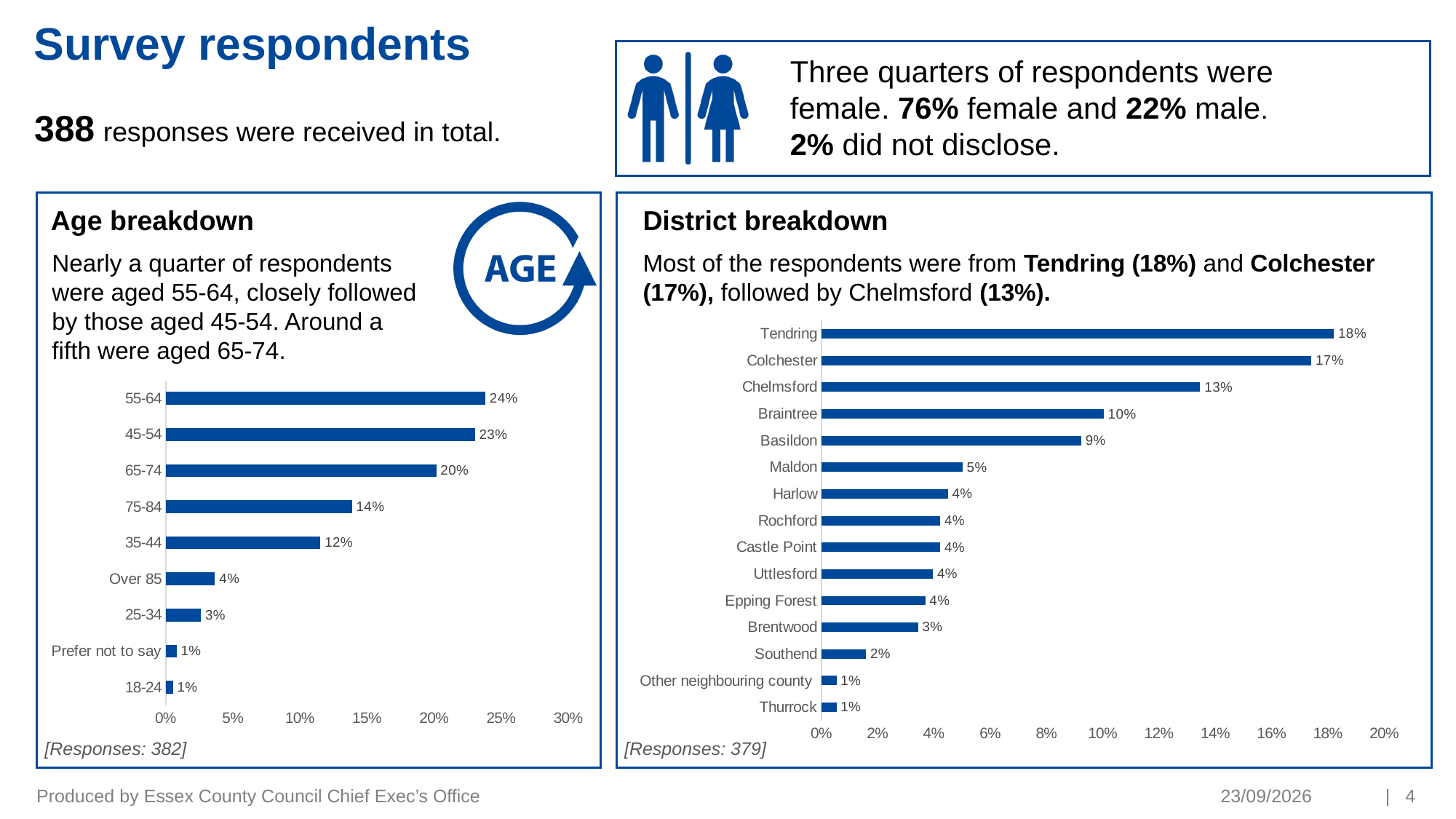
In the Age breakdown chart, which is larger, the value for 45-54 or the value for 65-74? 45-54 In the District breakdown chart, which district has the highest percentage? Tendring In the District breakdown chart, what is the difference between the Tendring and Chelmsford percentages? 5% In the Age breakdown chart, how many age categories are plotted? 9 In the Age breakdown chart, what percentage of respondents were aged 75-84? 14% In the District breakdown chart, how many categories are plotted? 15 In the District breakdown chart, what percentage of respondents were from Basildon? 9% What type of chart is the District breakdown chart? Bar chart In the Age breakdown chart, what is the difference between the 65-74 and 35-44 percentages? 8% In the District breakdown chart, what percentage of respondents were from Maldon? 5% In the Age breakdown chart, which age group has the highest percentage? 55-64 In the Age breakdown chart, what percentage of respondents were aged 55-64? 24%